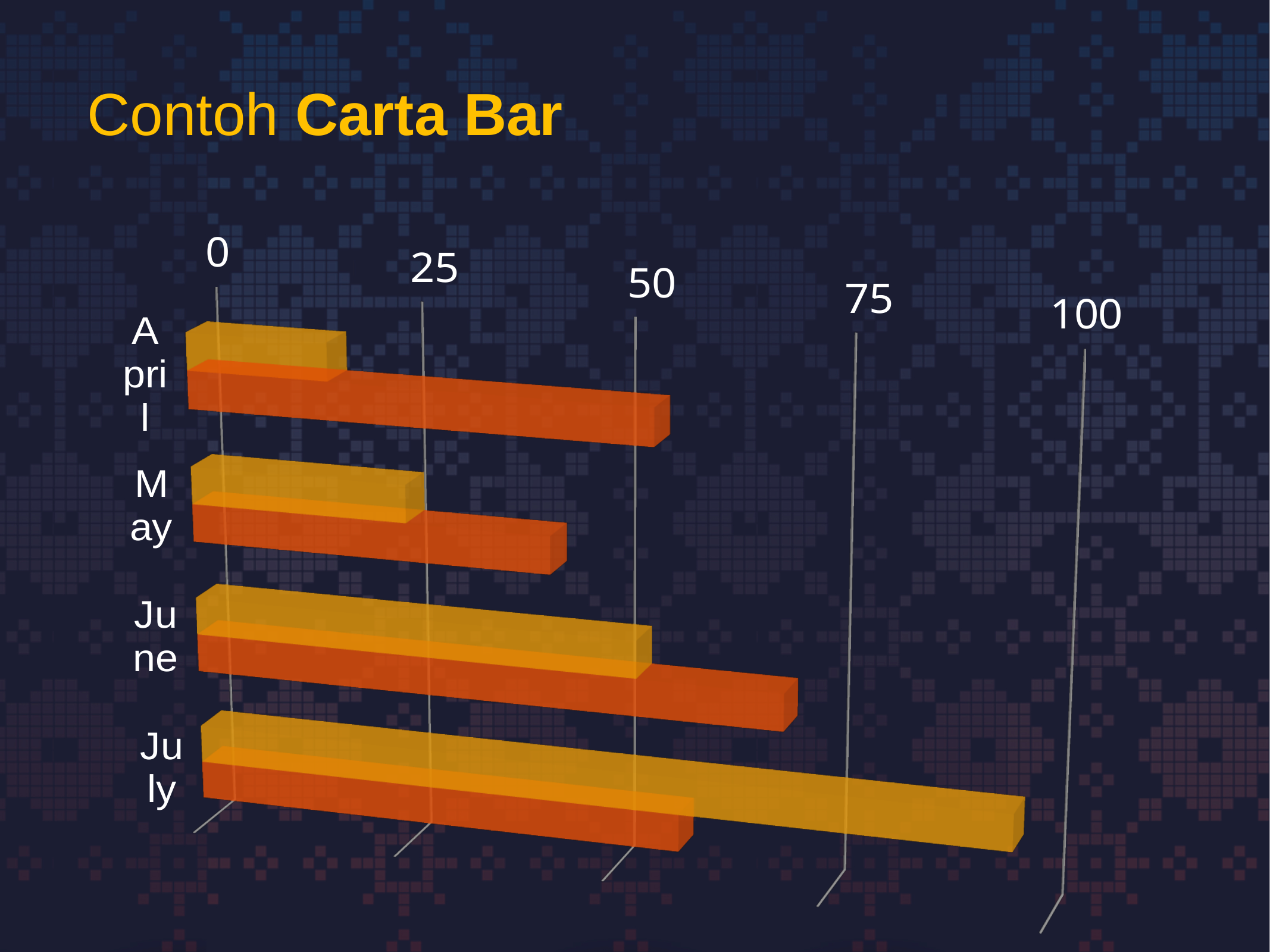
Is the value of the yellow bar for April greater or less than 25? less For April, which bar is longer, the yellow one or the orange one? orange What kind of chart is shown on the slide? bar chart What is the title of the slide? Contoh Carta Bar How many categories (months) are shown on the chart? 4 Which month has the shortest yellow bar? April Is the value of the yellow bar for July greater or less than 75? greater For July, which bar is longer, the yellow one or the orange one? yellow Which month has the longest yellow bar? July How many bars are plotted for each month on the chart? 2 Which month has the shortest orange bar? May Which month has the longest orange bar? June